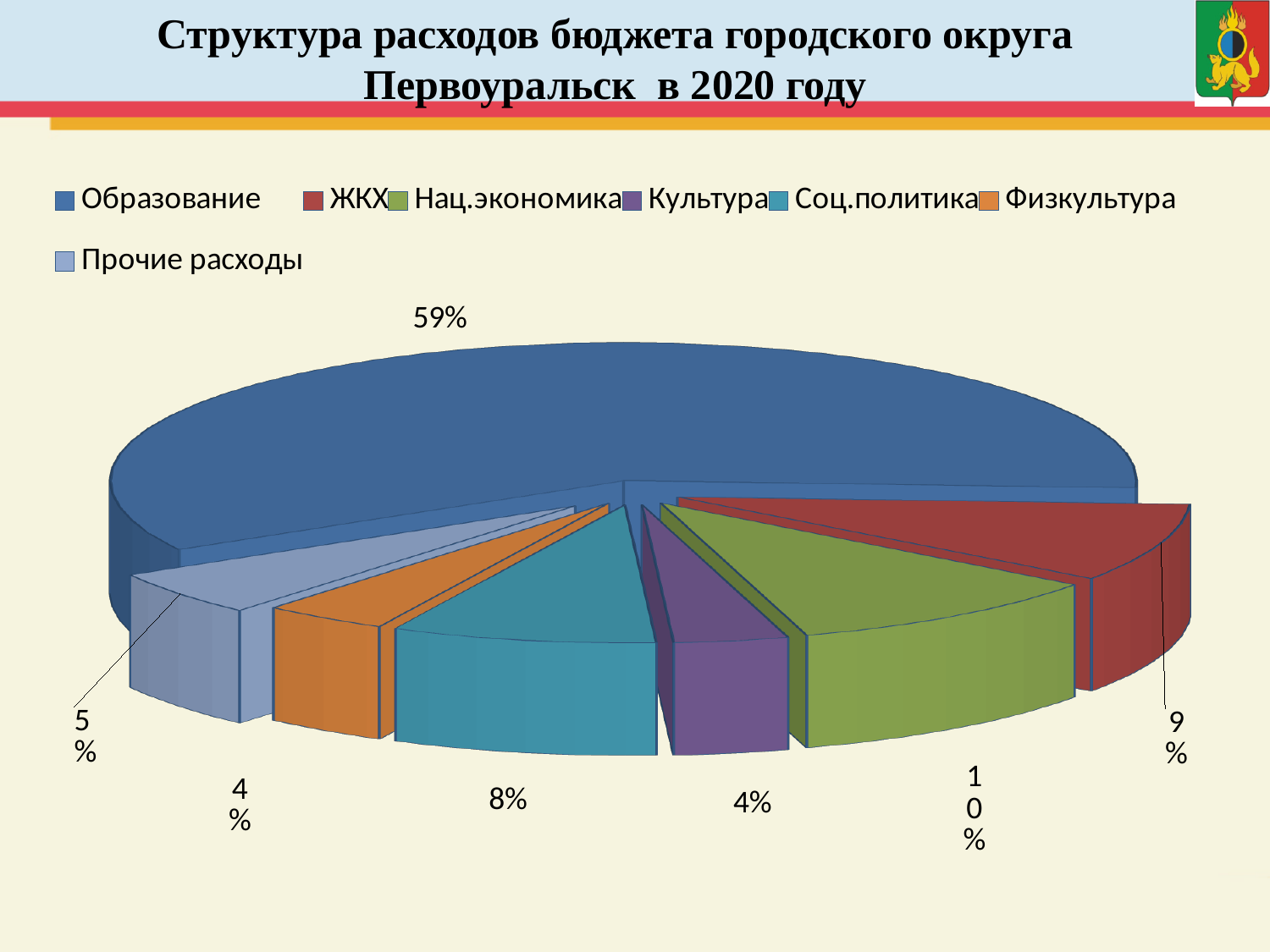
How many categories does the pie chart show? 7 What is the difference between the share for Соц.политика and the share for Прочие расходы? 3% What is the difference between the share for Образование and the share for Нац.экономика? 49% What is the title of the slide? Структура расходов бюджета городского округа Первоуральск в 2020 году Which is larger, the share for Нац.экономика or the share for ЖКХ? Нац.экономика What share of the budget expenditure goes to Соц.политика? 8% Which category has the largest share of the pie? Образование What kind of chart is shown on the slide? pie chart What share of the budget expenditure goes to Нац.экономика? 10% What share of the budget expenditure goes to Прочие расходы? 5% What share of the budget expenditure goes to Образование? 59% What share of the budget expenditure goes to ЖКХ? 9%